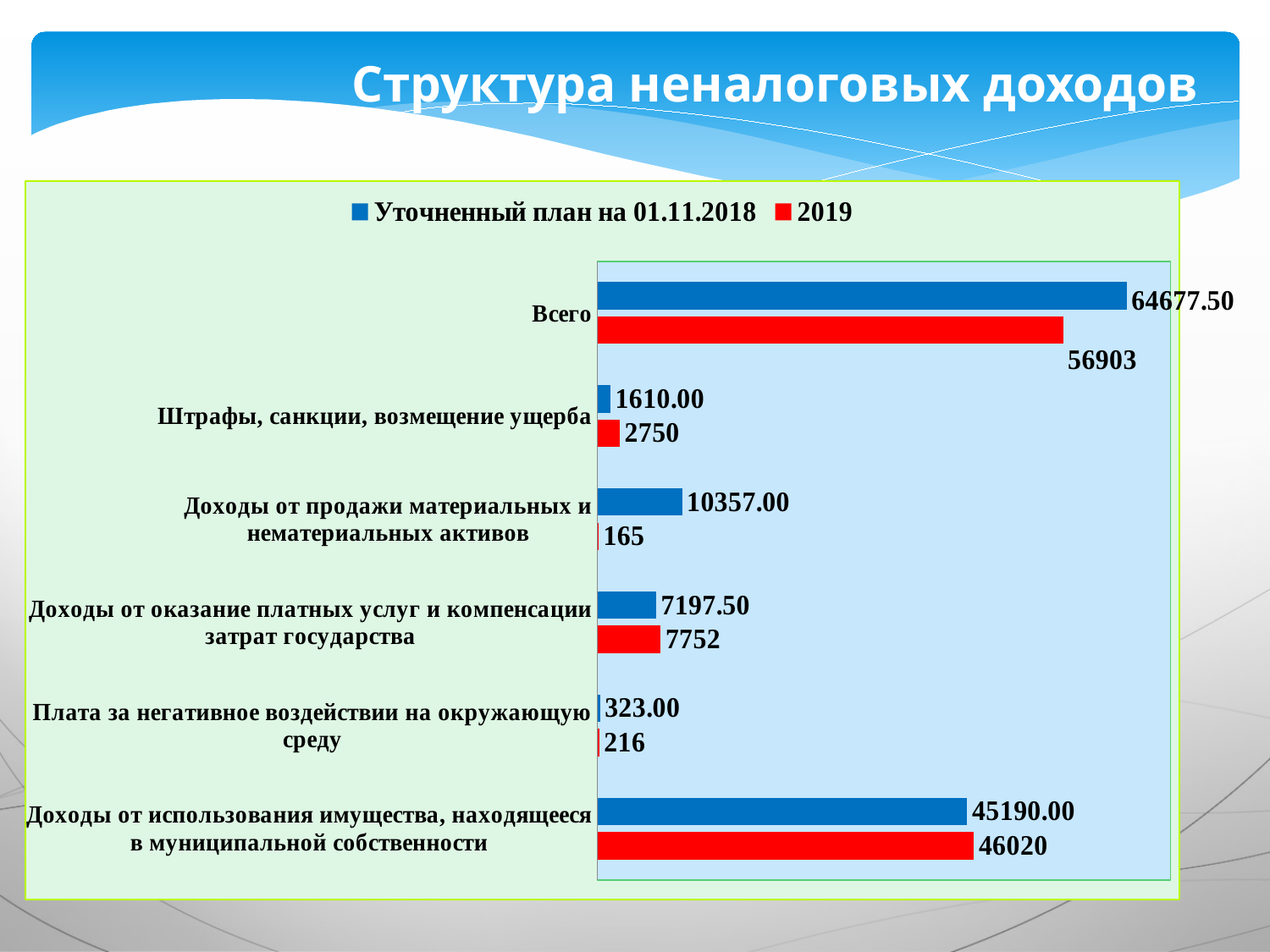
What is the value of the 2019 series for "Всего"? 56903 Which category has the lowest 2019 value? Доходы от продажи материальных и нематериальных активов How many series does the legend list? 2 For "Доходы от оказание платных услуг и компенсации затрат государства", which is larger: the 2019 value or the "Уточненный план на 01.11.2018" value? 2019 What is the 2019 value for "Доходы от продажи материальных и нематериальных активов"? 165 What is the value of "Уточненный план на 01.11.2018" for "Штрафы, санкции, возмещение ущерба"? 1610.00 What colour represents the 2019 series? Red What is the difference between the 2019 value and the "Уточненный план на 01.11.2018" value for "Штрафы, санкции, возмещение ущерба"? 1140 How many categories are shown on the chart? 6 What type of chart is shown on the slide? Bar chart Excluding "Всего", which category has the highest 2019 value? Доходы от использования имущества, находящееся в муниципальной собственности What is the "Уточненный план на 01.11.2018" value for "Доходы от использования имущества, находящееся в муниципальной собственности"? 45190.00